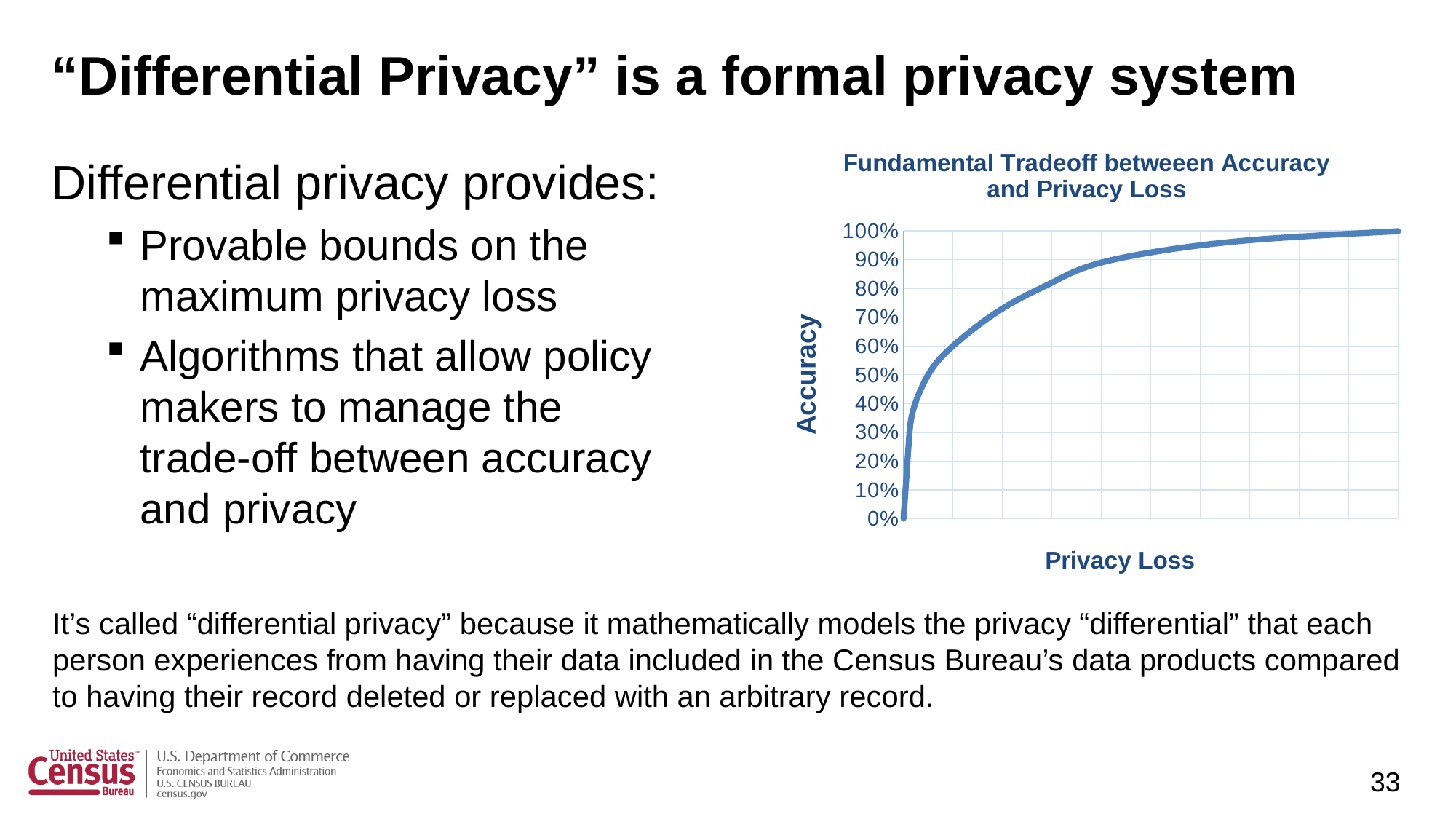
Is the accuracy at the left end of the curve greater or less than 10%? less What kind of chart is shown on the slide? line chart What is the title of the chart? Fundamental Tradeoff betweeen Accuracy and Privacy Loss Is the accuracy at the right end of the curve greater or less than 90%? greater How many lines are plotted on the chart? 1 What is the lowest value shown on the vertical axis of the chart? 0% At what accuracy value does the curve start at the left end of the chart? 0% Does accuracy rise or fall as privacy loss increases along the x axis? rise What is the label of the vertical axis of the chart? Accuracy What is the highest value shown on the vertical axis of the chart? 100%